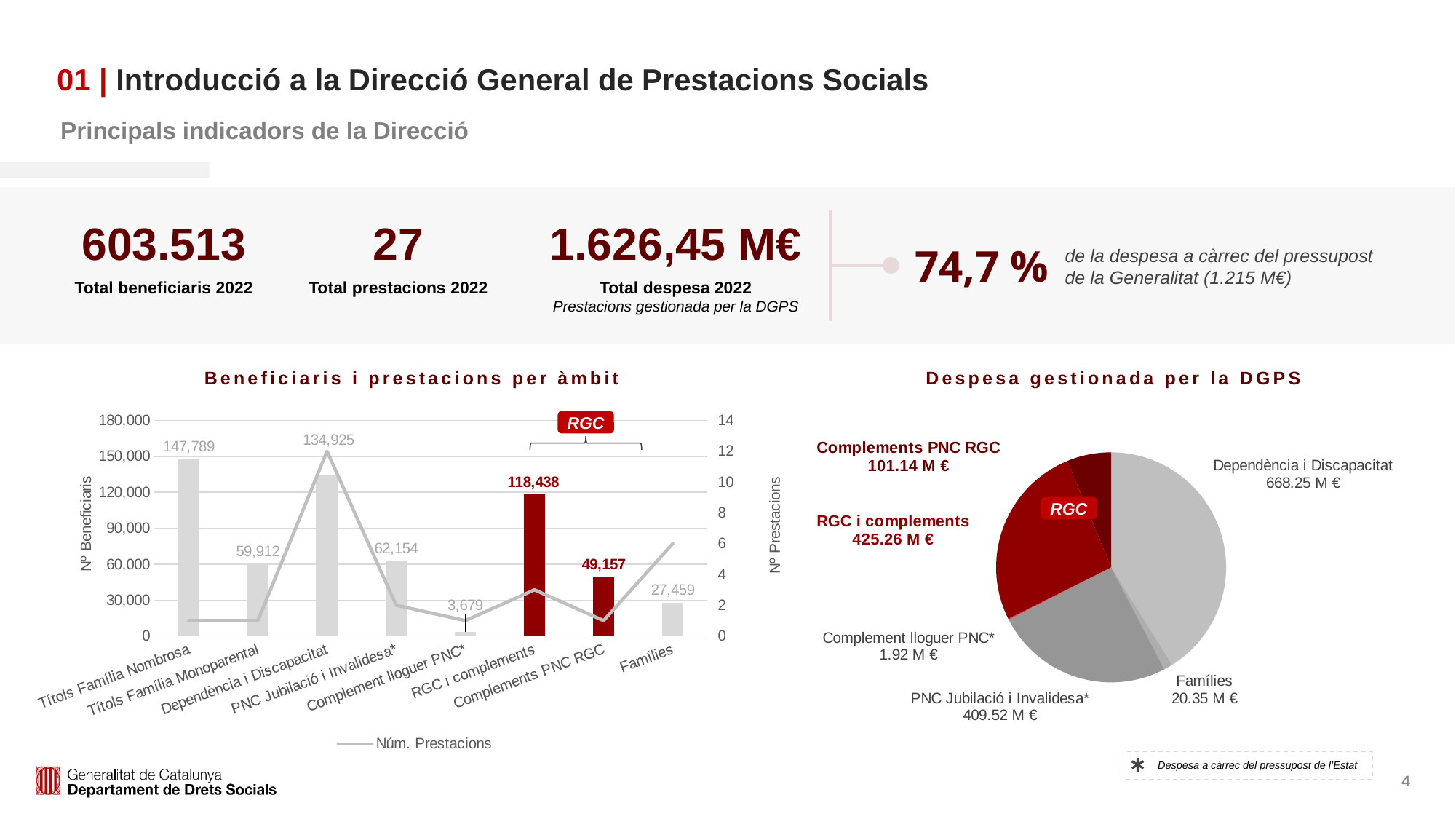
How many categories are shown on the x axis of the 'Beneficiaris i prestacions per àmbit' chart? 8 In the 'Beneficiaris i prestacions per àmbit' chart, how many beneficiaris are shown for Títols Família Nombrosa? 147,789 In the 'Despesa gestionada per la DGPS' pie chart, what is the difference between RGC i complements and PNC Jubilació i Invalidesa*? 15.74 M € In the 'Beneficiaris i prestacions per àmbit' chart, which category has the lowest number of beneficiaris? Complement lloguer PNC* What is the legend entry shown below the 'Beneficiaris i prestacions per àmbit' chart? Núm. Prestacions In the 'Beneficiaris i prestacions per àmbit' chart, what is the number of beneficiaris for RGC i complements? 118,438 In the 'Despesa gestionada per la DGPS' pie chart, what is the value for Dependència i Discapacitat? 668.25 M € In the 'Beneficiaris i prestacions per àmbit' chart, what is the difference in beneficiaris between Títols Família Nombrosa and Dependència i Discapacitat? 12,864 In the 'Beneficiaris i prestacions per àmbit' chart, is the Núm. Prestacions value for Dependència i Discapacitat greater or less than 10? greater In the 'Beneficiaris i prestacions per àmbit' chart, which has more beneficiaris: RGC i complements or Complements PNC RGC? RGC i complements In the 'Beneficiaris i prestacions per àmbit' chart, which category has the highest number of beneficiaris? Títols Família Nombrosa In the 'Despesa gestionada per la DGPS' pie chart, which slice has the smallest value? Complement lloguer PNC*